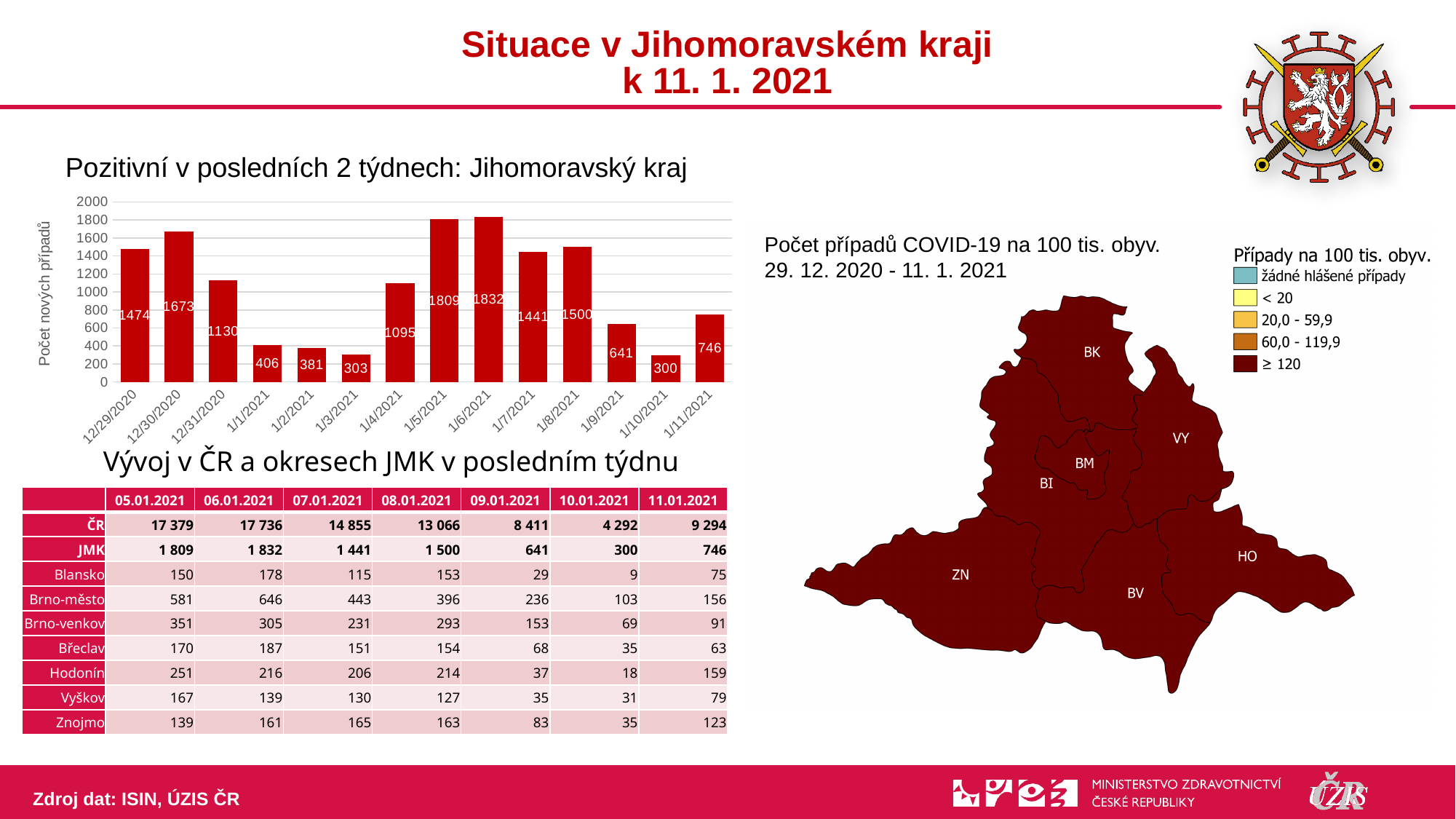
What is the difference between the values for 1/6/2021 and 1/5/2021 in the bar chart? 23 Which is larger in the bar chart, the value for 1/8/2021 or the value for 1/7/2021? 1/8/2021 What kind of chart is shown under the heading 'Pozitivní v posledních 2 týdnech: Jihomoravský kraj'? bar chart What is the y-axis label of the bar chart? Počet nových případů How many bars are in the bar chart? 14 Which date has the lowest value in the bar chart? 1/10/2021 What is the value for 1/11/2021 in the bar chart? 746 Which date has the highest value in the bar chart? 1/6/2021 Is the value for 1/9/2021 in the bar chart greater or less than 800? less What is the value for 1/3/2021 in the bar chart? 303 What is the value for 12/29/2020 in the bar chart? 1474 What is the difference between the values for 12/30/2020 and 12/31/2020 in the bar chart? 543